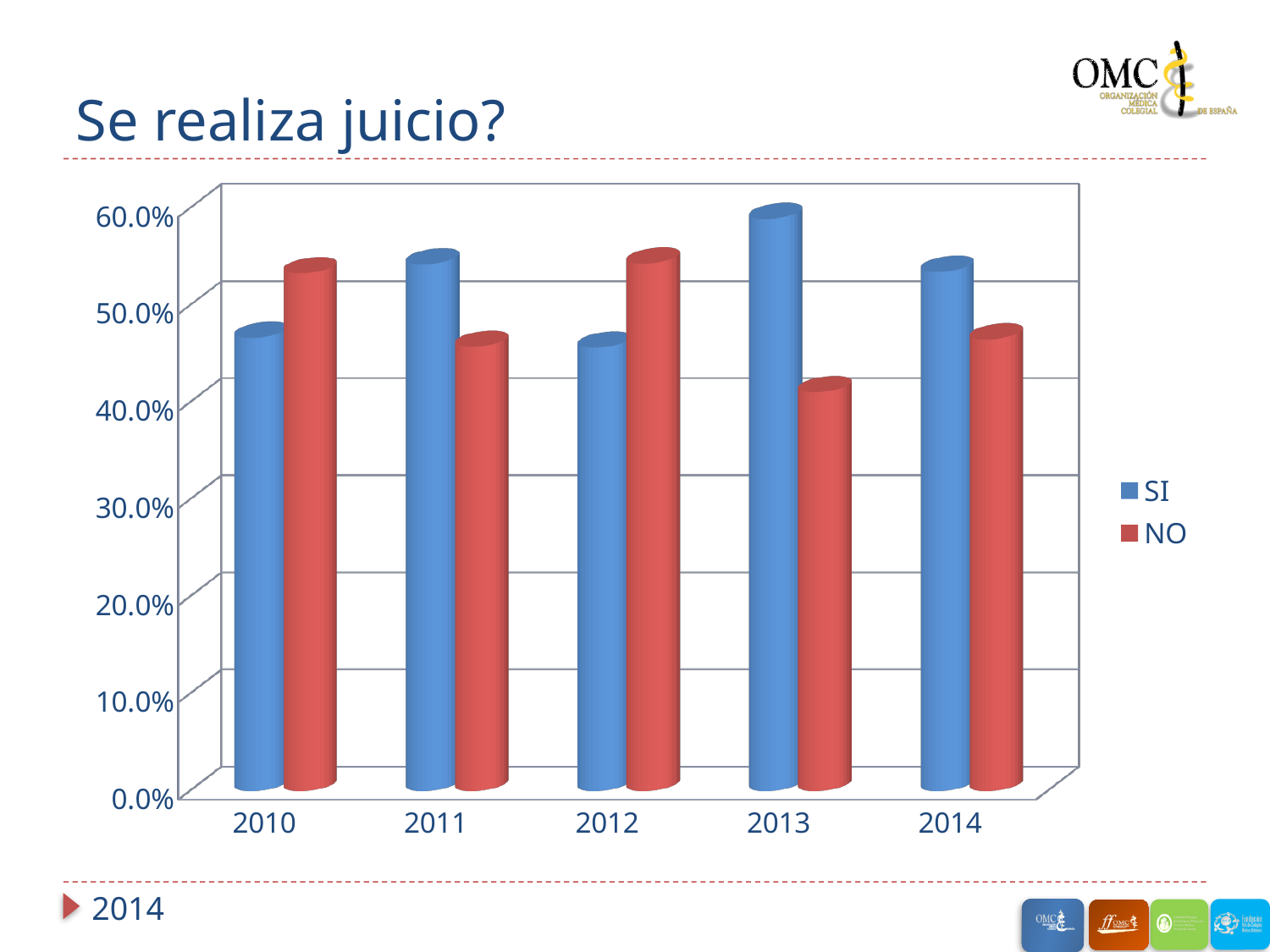
What kind of chart is shown on the slide? bar chart In which year is the SI value highest? 2013 Is the NO value for 2013 greater or less than 50.0%? less What is the title of the slide containing the chart? Se realiza juicio? How many years are shown on the x axis? 5 Is the SI value for 2013 greater or less than 50.0%? greater Is the SI value for 2010 greater or less than 50.0%? less How many series does the legend list? 2 In which year is the NO value lowest? 2013 In 2013, which is larger, SI or NO? SI Which colour represents the NO series in the legend? red In 2010, which is larger, SI or NO? NO